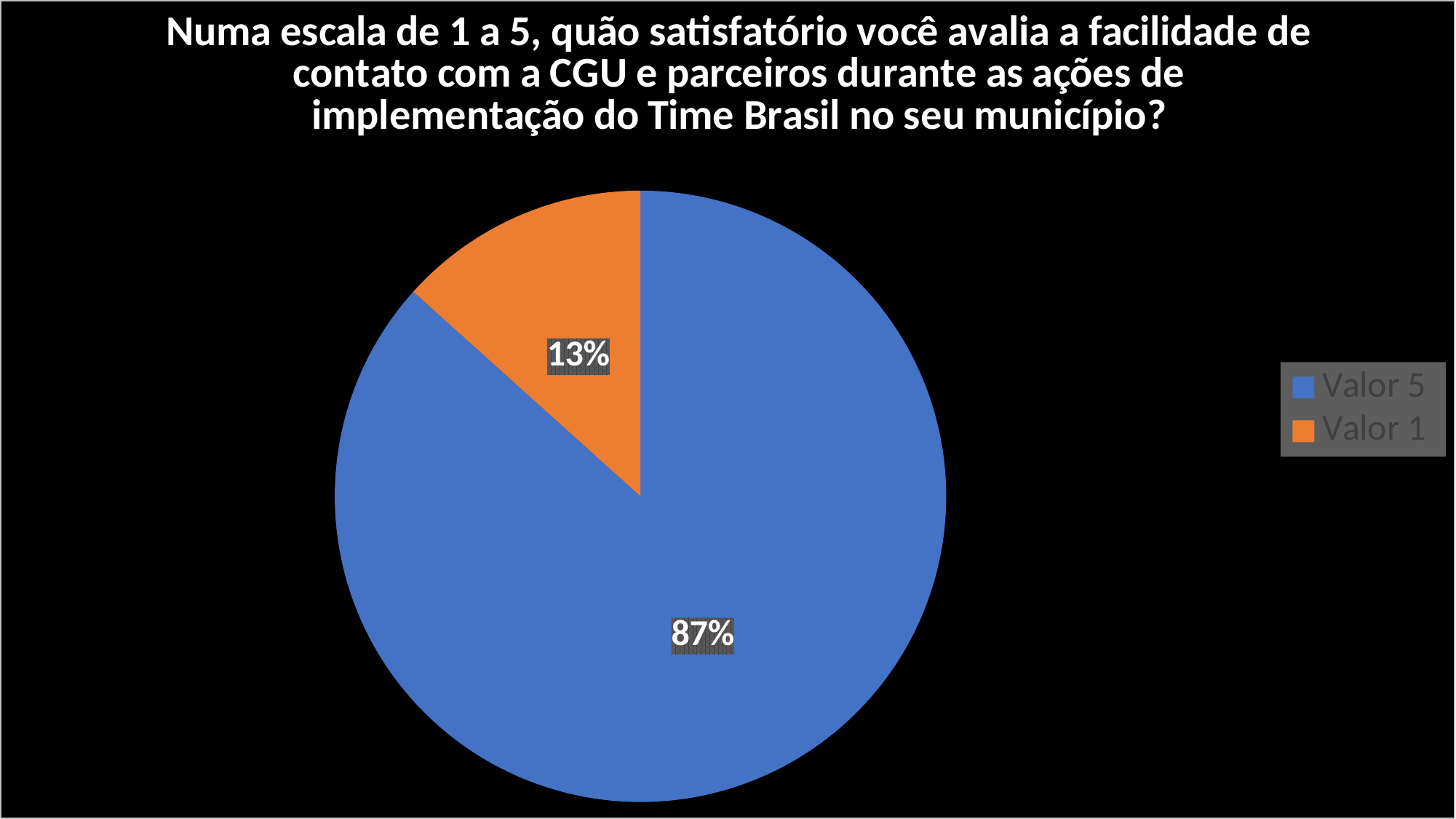
Which category has the smallest slice of the pie? Valor 1 Which slice is larger, Valor 5 or Valor 1? Valor 5 How many entries does the legend list? 2 Which category has the largest slice of the pie? Valor 5 What kind of chart is shown on the slide? pie chart What colour is the Valor 5 slice? blue What share of the pie does Valor 5 represent? 87% What colour is the Valor 1 slice? orange What share of the pie does Valor 1 represent? 13% How many slices does the pie chart have? 2 What is the total of the two slice percentages shown on the pie? 100% What is the difference in percentage points between the Valor 5 slice and the Valor 1 slice? 74